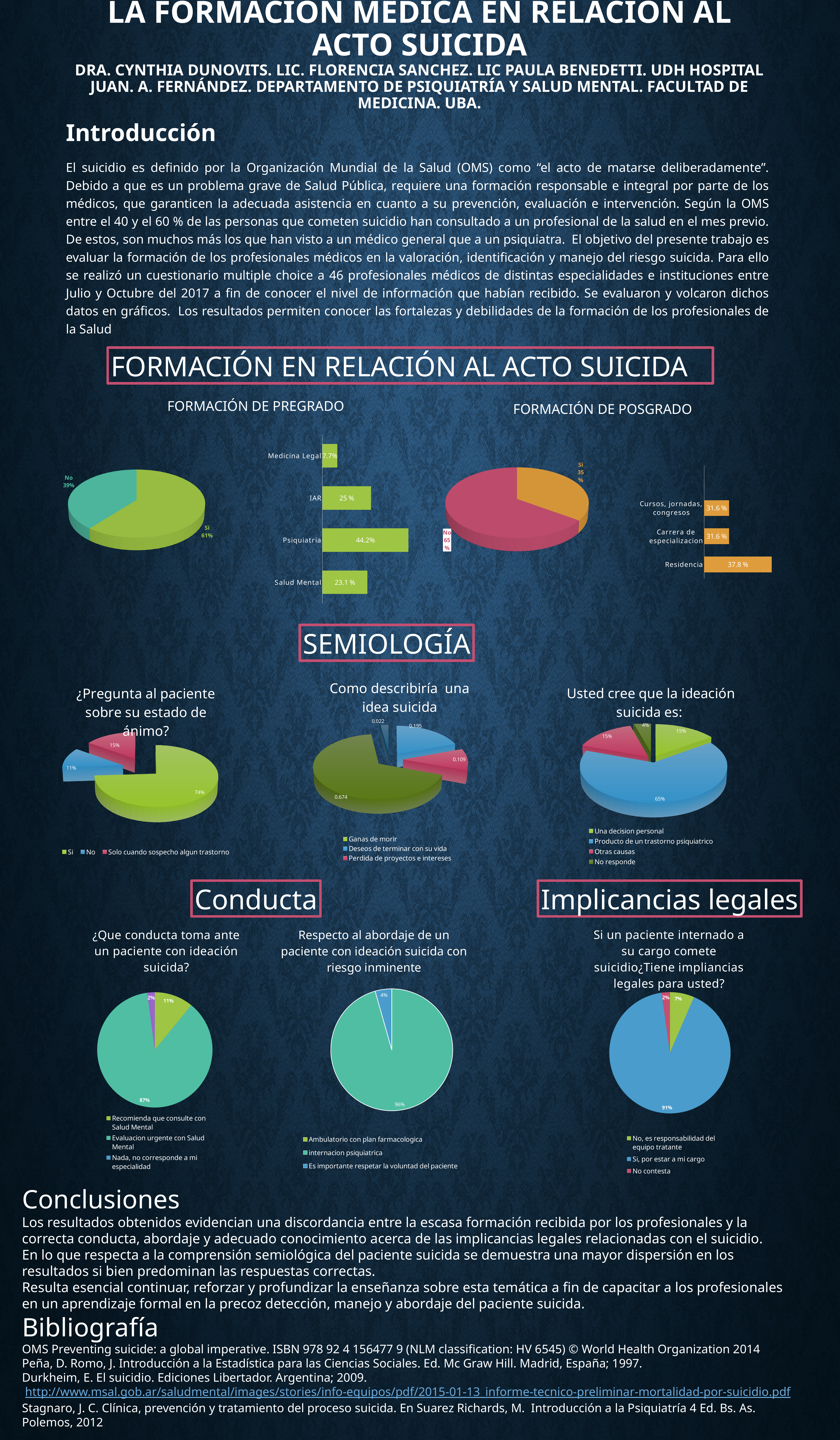
In the pie chart '¿Pregunta al paciente sobre su estado de ánimo?', what percentage answered 'Si'? 74% In the pie chart '¿Que conducta toma ante un paciente con ideación suicida?', what is the difference between 'Evaluacion urgente con Salud Mental' and 'Recomienda que consulte con Salud Mental'? 76% How many categories does the bar chart under 'Formación de posgrado' show? 3 In the bar chart under 'Formación de posgrado', what is the value for Residencia? 37.8 % In the 'Formación de pregrado' pie chart, what percentage answered 'Si'? 61% What type of chart is used for 'Si un paciente internado a su cargo comete suicidio¿Tiene impliancias legales para usted?'? pie chart In the pie chart 'Respecto al abordaje de un paciente con ideación suicida con riesgo inminente', what percentage chose 'internacion psiquiatrica'? 96% In the bar chart under 'Formación de pregrado', what is the value for Medicina Legal? 7.7% In the 'Formación de posgrado' pie chart, what percentage answered 'No'? 65% In the bar chart under 'Formación de pregrado', which category has the highest value? Psiquiatria In the pie chart 'Usted cree que la ideación suicida es:', what share is 'Producto de un trastorno psiquiatrico'? 65%